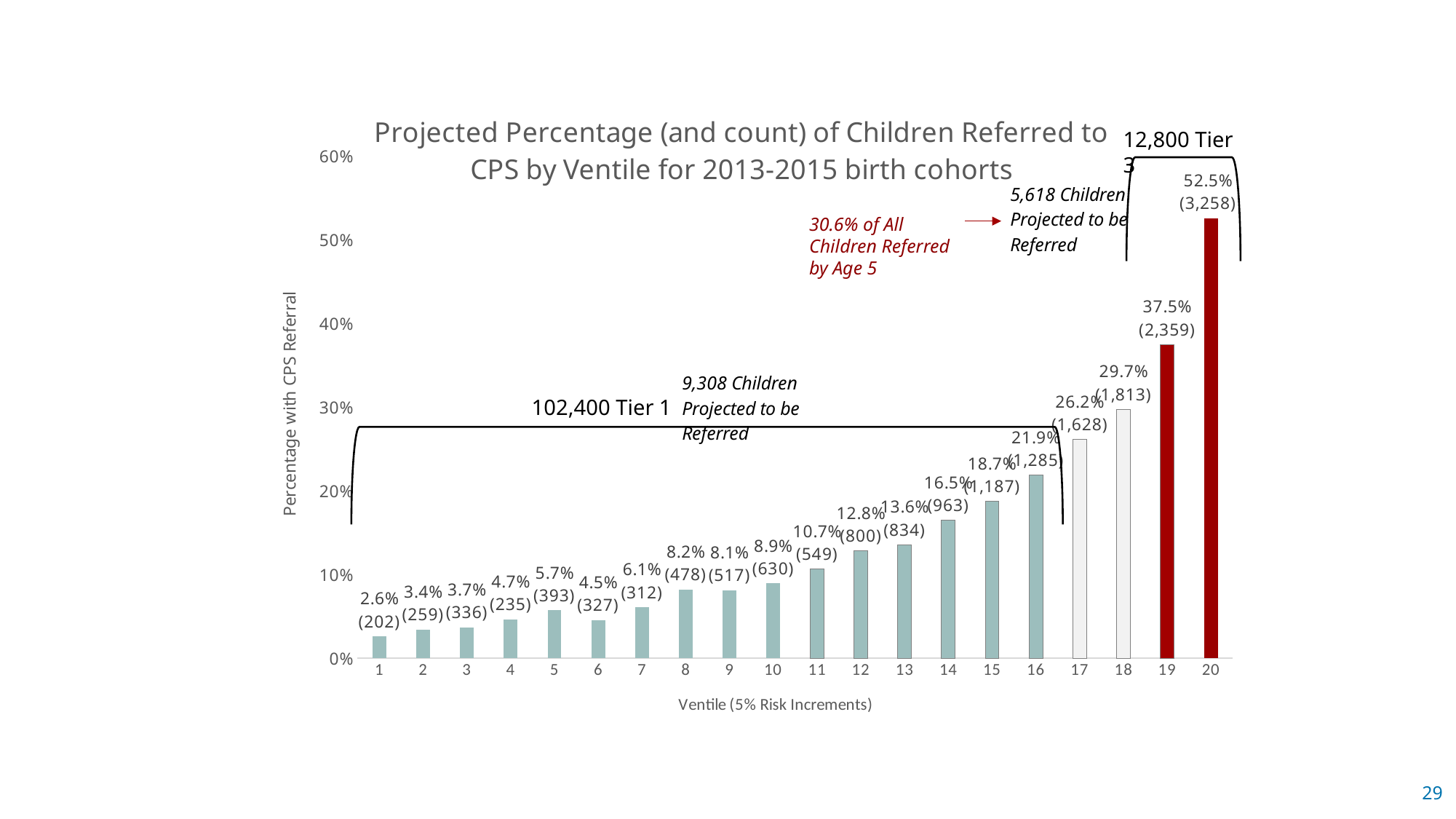
What is the projected count of children referred for ventile 15? 1,187 What is the difference in percentage points between ventile 20 and ventile 19? 15.0% What kind of chart is shown on the slide? Bar chart Do the projected referral percentages generally rise or fall as the ventile number increases? Rise What percentage of children in ventile 20 are projected to be referred to CPS? 52.5% Is the value for ventile 17 greater or less than 20%? greater How many ventiles are plotted on the x axis? 20 Which ventile has the lowest projected percentage of children referred to CPS? 1 Which ventile has the highest projected percentage of children referred to CPS? 20 What percentage is shown for ventile 11? 10.7% What is the label of the x axis? Ventile (5% Risk Increments) Which has a higher projected referral percentage, ventile 5 or ventile 6? Ventile 5